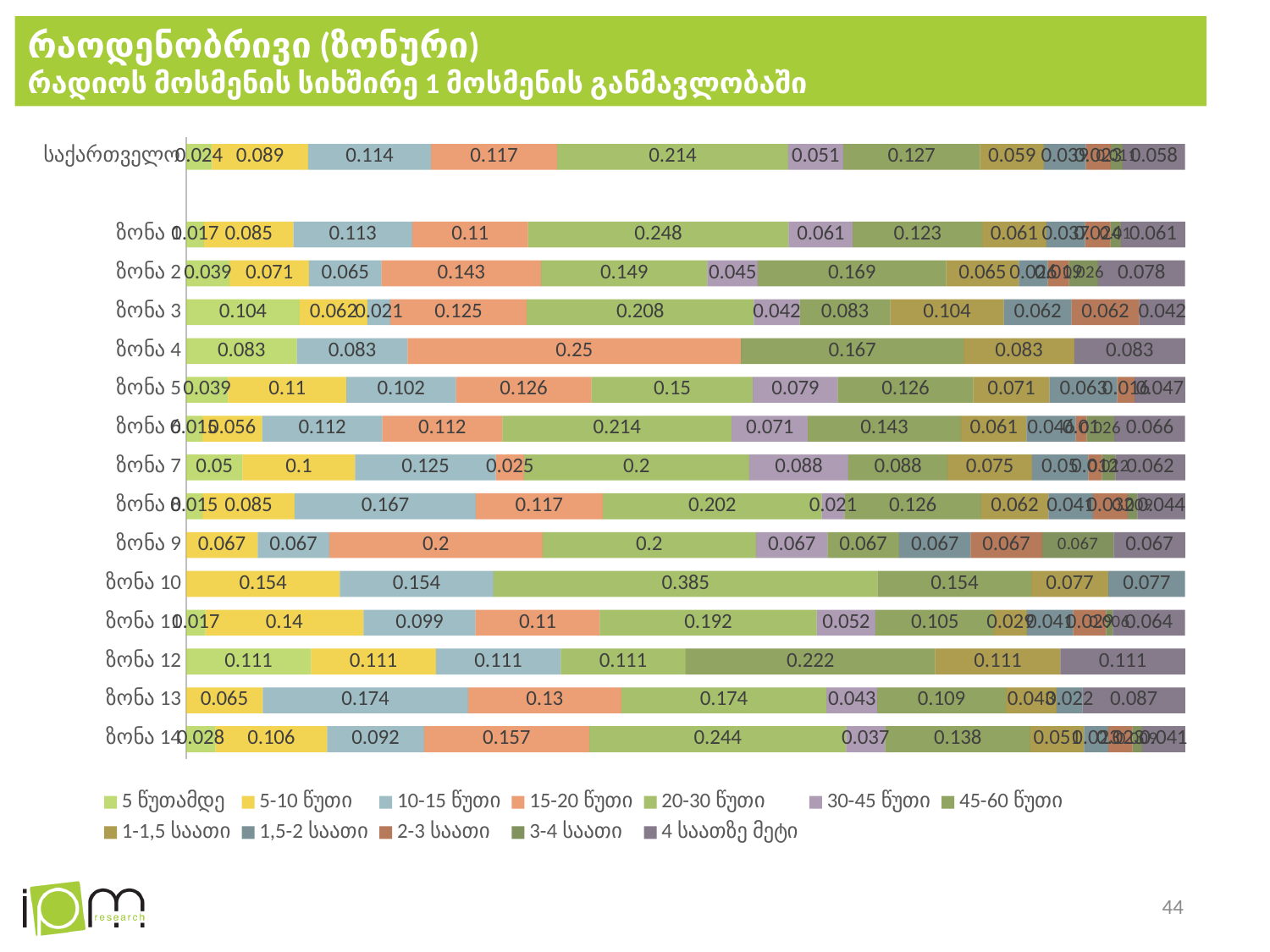
What is the value of the 20-30 წუთი segment for საქართველო? 0.214 What is the value of the 15-20 წუთი segment for ზონა 4? 0.25 For ზონა 10, what is the difference between the 20-30 წუთი segment (0.385) and the 10-15 წუთი segment (0.154)? 0.231 How many categories (rows) are plotted in the chart? 15 What is the value of the 20-30 წუთი segment for ზონა 12? 0.111 Which series has the largest segment in the საქართველო bar? 20-30 წუთი How many series does the legend list? 12 What is the first entry listed in the legend? 5 წუთამდე For საქართველო, which is larger: the 20-30 წუთი segment or the 10-15 წუთი segment? 20-30 წუთი What is the value of the 10-15 წუთი segment for ზონა 13? 0.174 What kind of chart is shown on the slide? stacked bar chart What is the value of the 20-30 წუთი segment for ზონა 10? 0.385